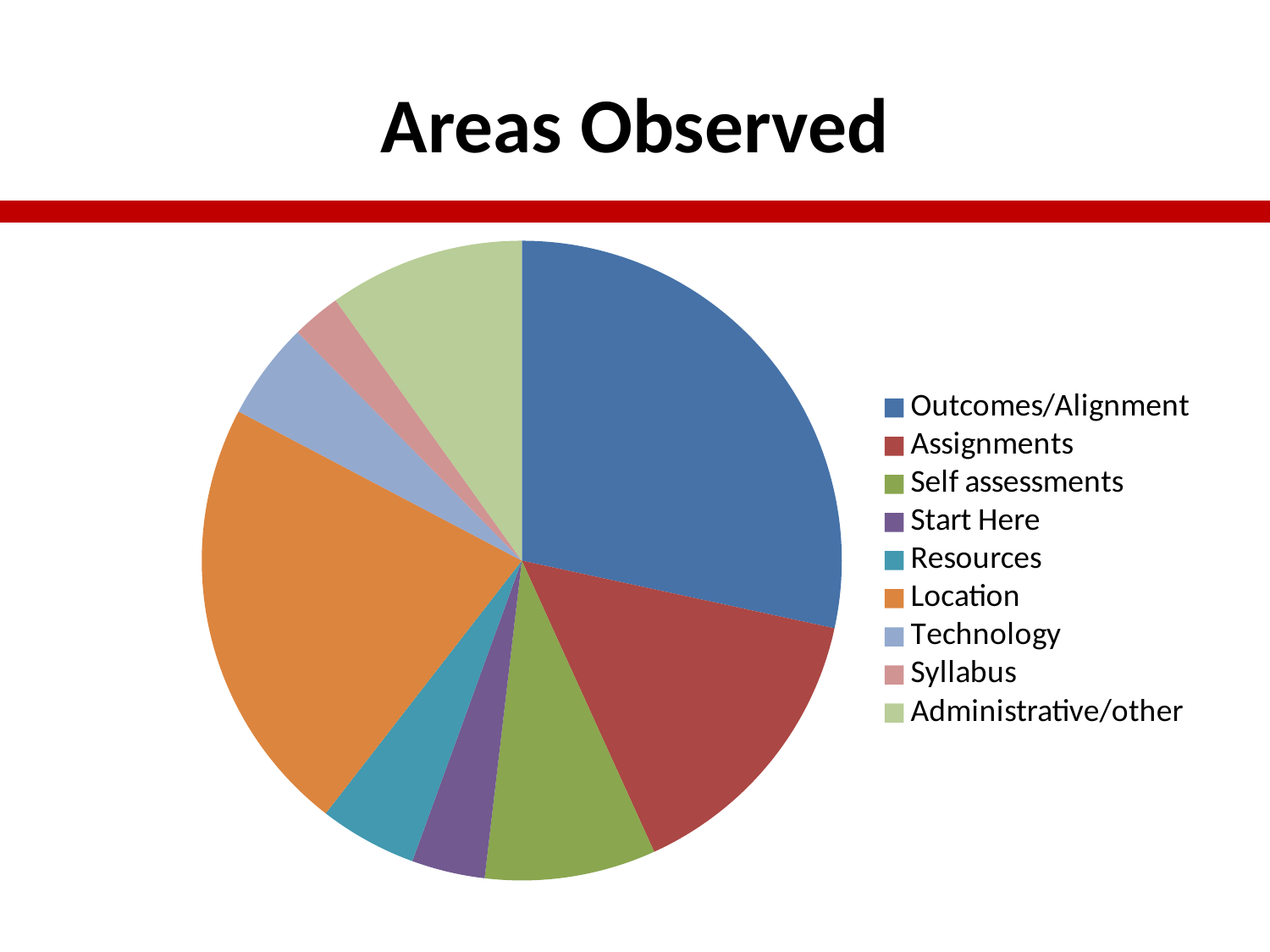
Which slice is larger, Administrative/other or Syllabus? Administrative/other Which category is the second-largest slice of the pie chart? Location Which slice is larger, Location or Self assessments? Location Which slice is larger, Assignments or Resources? Assignments What is the title of the slide containing the pie chart? Areas Observed Which category has the largest slice of the pie chart? Outcomes/Alignment How many categories (slices) does the pie chart have? 9 What colour is the Location slice in the pie chart? orange What kind of chart is shown on the slide? pie chart